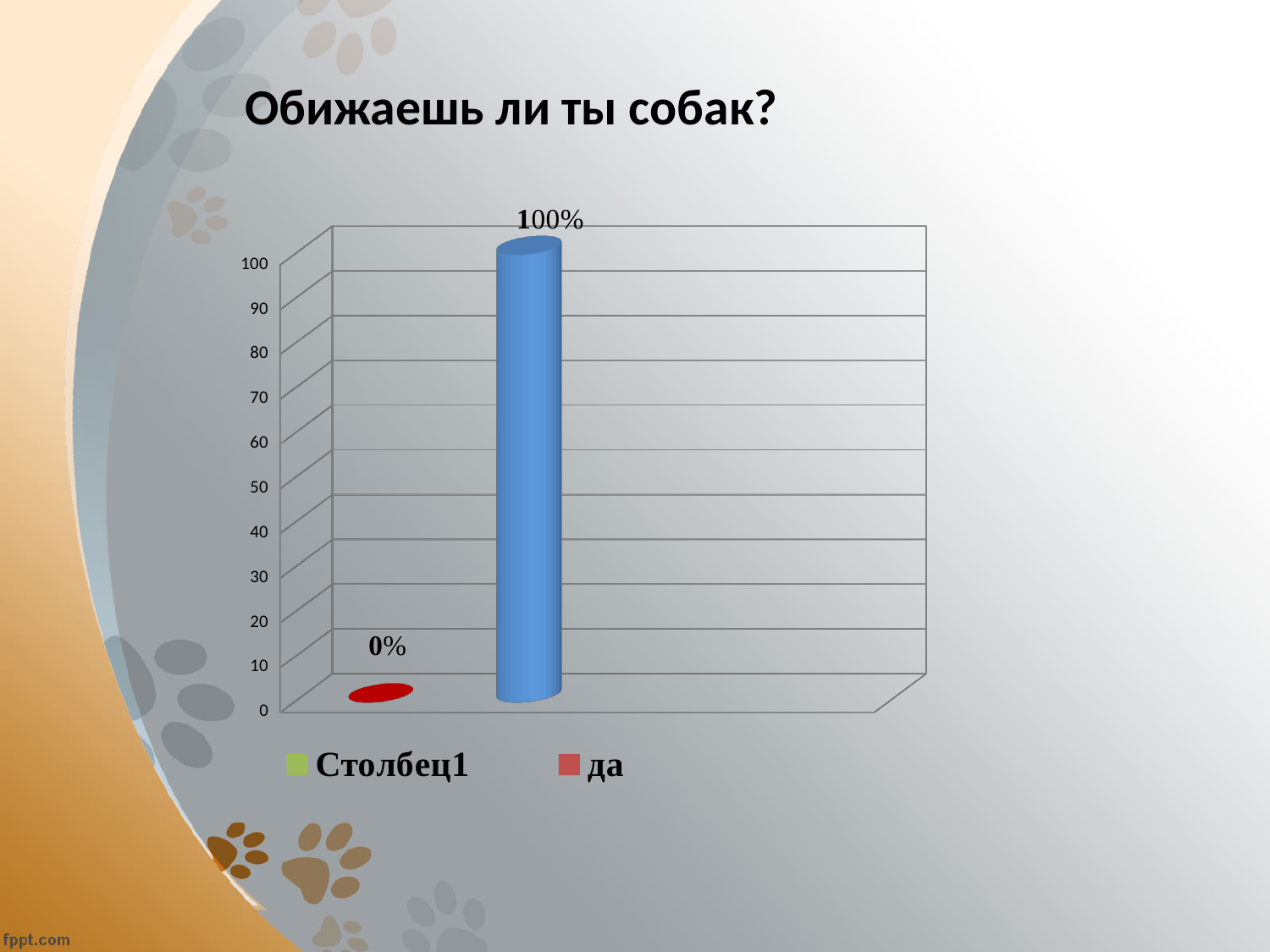
How many bars are plotted in the chart? 2 What is the difference between the two labeled values on the chart? 100% Which bar is taller, the red one or the blue one? the blue one What is the title of the chart on the slide? Обижаешь ли ты собак? What value is labeled on the red bar in the chart? 0% What kind of chart is shown on the slide? bar chart What is the highest value labeled on the chart? 100% What value is labeled on the blue bar in the chart? 100% What are the two entries listed in the chart legend? Столбец1 and да How many entries does the chart legend list? 2 What is the lowest value labeled on the chart? 0%